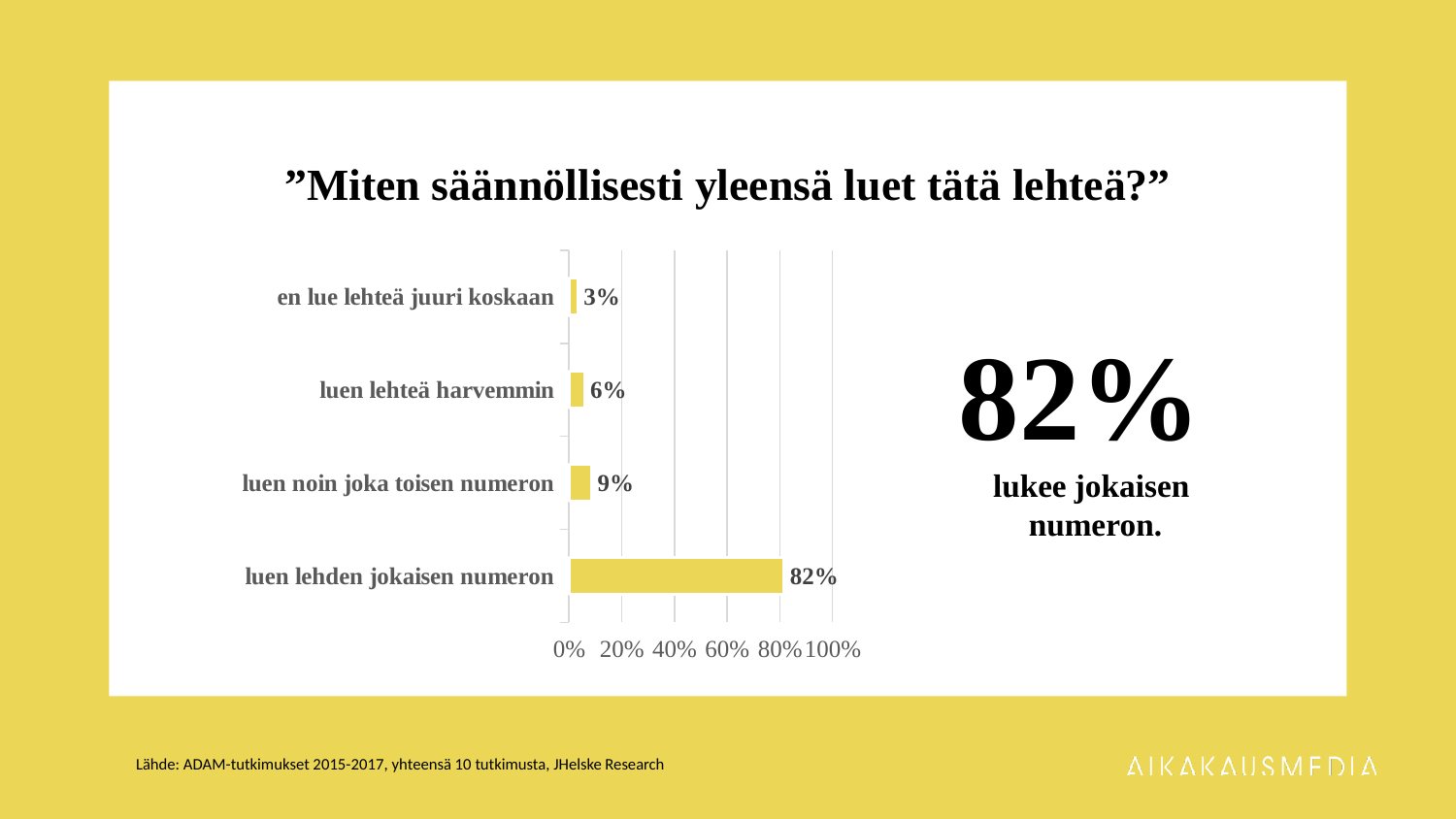
How many categories are shown in the chart? 4 What is the value for "luen noin joka toisen numeron"? 9% Which is larger: "luen lehteä harvemmin" or "luen noin joka toisen numeron"? luen noin joka toisen numeron Which category has the highest value? luen lehden jokaisen numeron What is the difference between "luen lehden jokaisen numeron" and "luen noin joka toisen numeron"? 73% What is the value for "luen lehteä harvemmin"? 6% Is the value for "luen lehden jokaisen numeron" greater or less than 60%? greater What kind of chart is shown on the slide? bar chart Which category has the lowest value? en lue lehteä juuri koskaan What is the value for "en lue lehteä juuri koskaan"? 3% What is the difference between "luen noin joka toisen numeron" and "luen lehteä harvemmin"? 3% What is the value for "luen lehden jokaisen numeron"? 82%